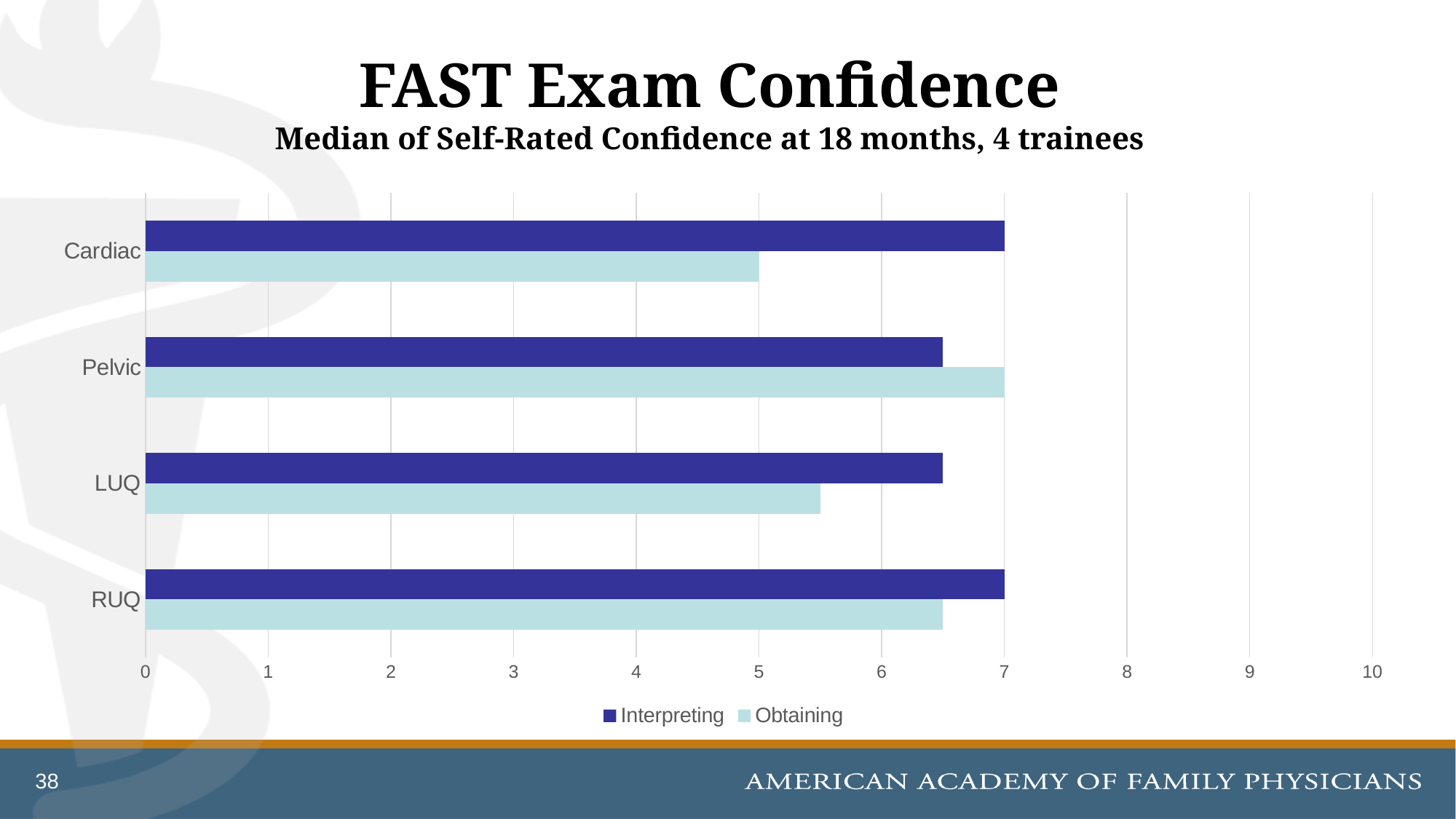
What is the Obtaining value for Pelvic? 7 Is the Obtaining value for LUQ greater or less than 6? less For Pelvic, which is larger: the Interpreting value or the Obtaining value? Obtaining What type of chart is shown on the slide? Bar chart How many series does the legend list? 2 Which series is shown in dark blue in the legend? Interpreting What is the Obtaining value for Cardiac? 5 What is the Interpreting value for Cardiac? 7 What is the difference between the Interpreting and Obtaining values for Cardiac? 2 How many categories are shown on the chart? 4 What is the Interpreting value for RUQ? 7 Which category has the lowest Obtaining value? Cardiac